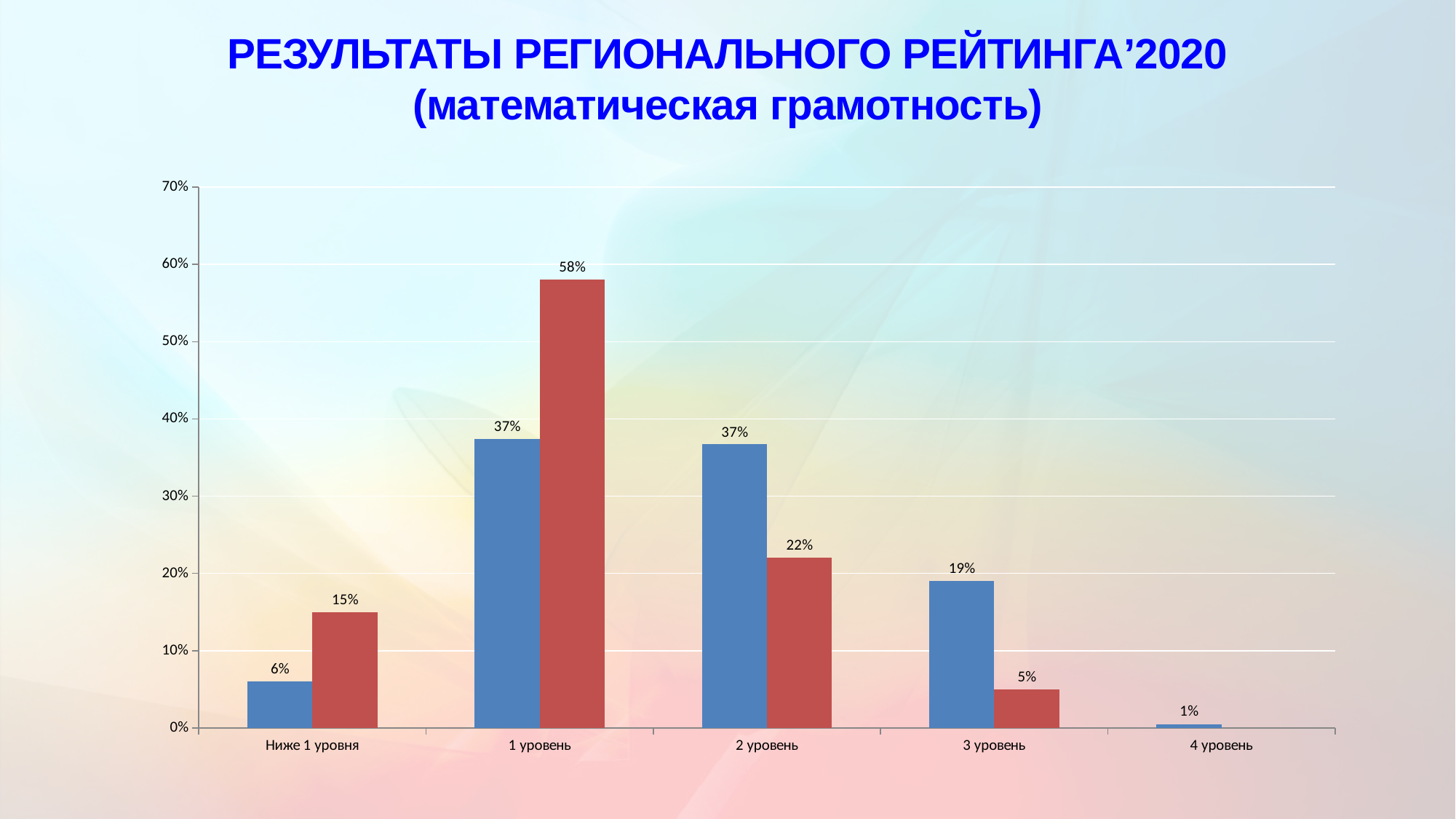
What is the title of the slide? РЕЗУЛЬТАТЫ РЕГИОНАЛЬНОГО РЕЙТИНГА’2020 (математическая грамотность) How many categories are shown on the x axis? 5 What is the value of the blue bar for "4 уровень"? 1% Which category has the highest red bar? 1 уровень What is the value of the red bar for "Ниже 1 уровня"? 15% What is the difference between the red and blue bars for "1 уровень"? 21% What is the value of the blue bar for "1 уровень"? 37% For "2 уровень", which bar is larger, the blue or the red? blue What is the value of the blue bar for "3 уровень"? 19% What is the value of the red bar for "1 уровень"? 58% What kind of chart is shown on the slide? bar chart Which category has the lowest blue bar? 4 уровень